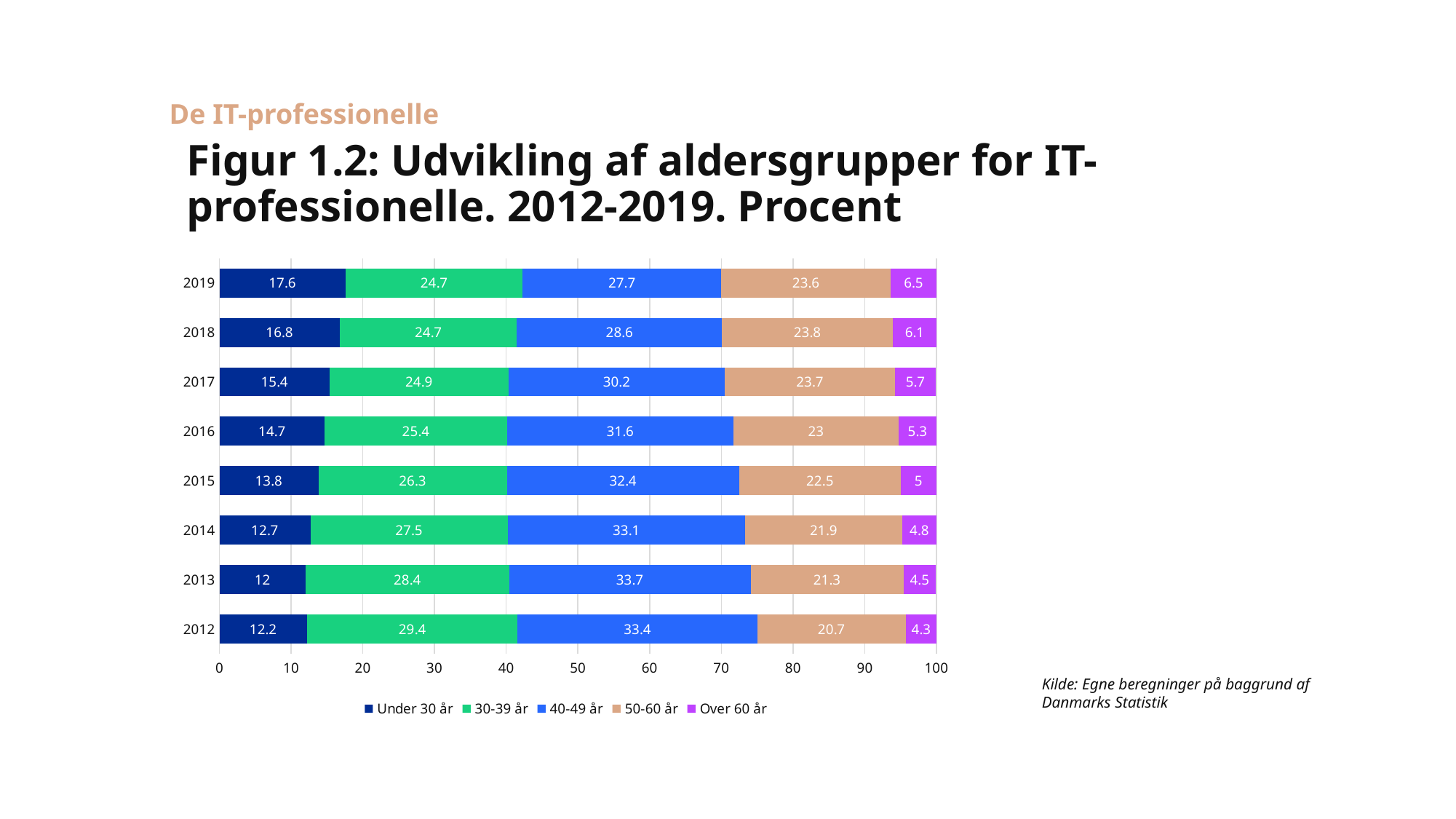
What kind of chart is shown on the slide? Stacked bar chart What is the value for Under 30 år in 2019? 17.6 How many series does the legend list? 5 What is the difference between the 40-49 år value in 2013 and in 2019? 6 What is the value for Over 60 år in 2012? 4.3 What is the difference between the Under 30 år value in 2019 and in 2012? 5.4 Which year has the lowest value for Over 60 år? 2012 Does the value for Over 60 år rise or fall from 2012 to 2019? Rise How many years are shown on the chart? 8 What is the value for 40-49 år in 2015? 32.4 Which year has the highest value for Under 30 år? 2019 In 2016, which is larger: the value for 30-39 år or for 50-60 år? 30-39 år